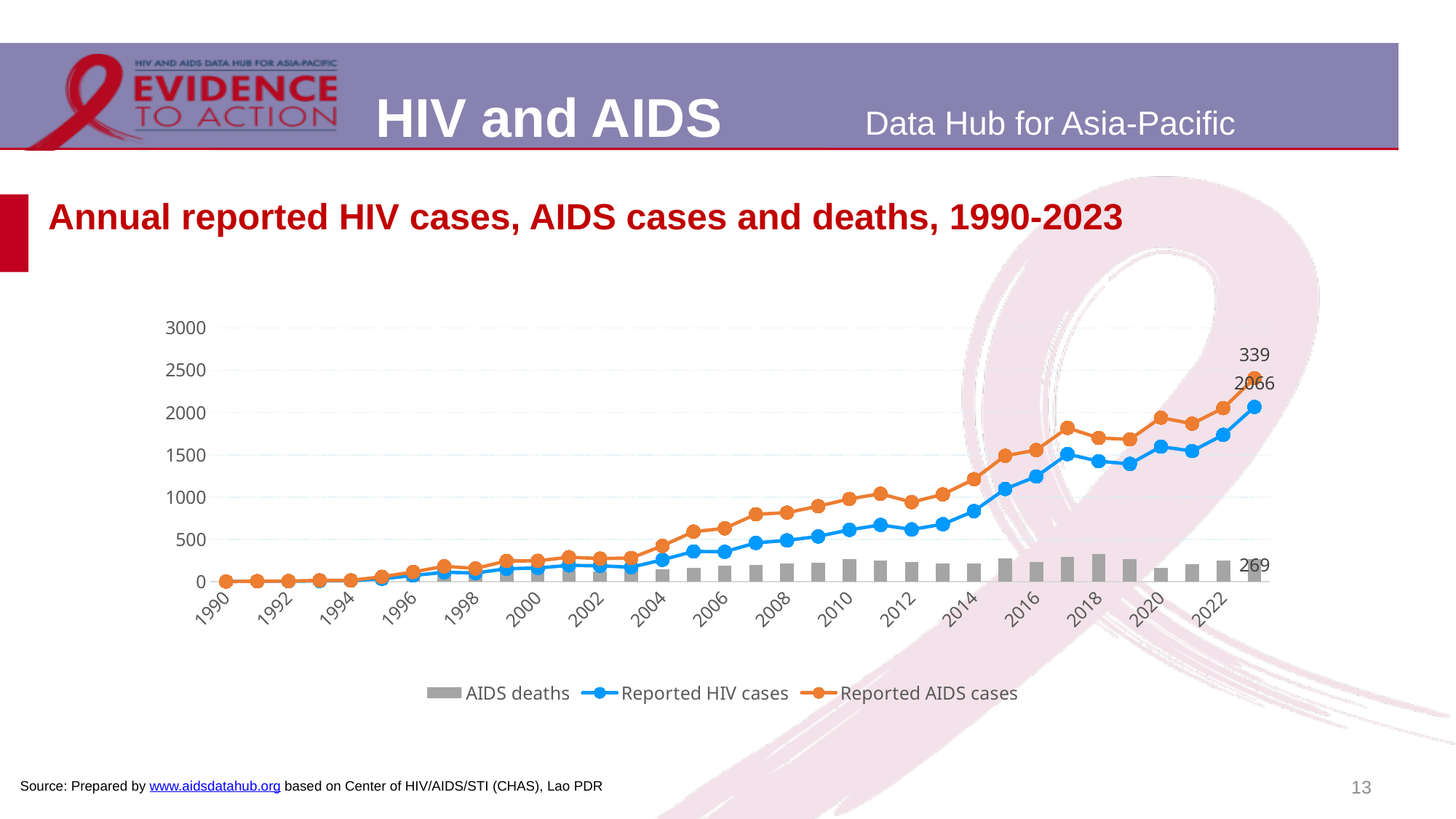
In which year are reported HIV cases highest? 2023 How many series does the legend list? 3 Is the value for AIDS deaths in 2018 greater or less than 500? less What is the number of reported HIV cases in 2023? 2066 Which series is shown as grey bars? AIDS deaths What is the number of AIDS deaths in 2023? 269 What is the difference between reported HIV cases and AIDS deaths in 2023? 1797 Is the value for reported HIV cases in 2023 greater or less than 2000? greater What kind of chart is shown on the slide? A combined bar and line chart Do reported HIV cases generally rise or fall from 1990 to 2023? Rise In 2023, which is larger: reported AIDS cases or reported HIV cases? Reported HIV cases